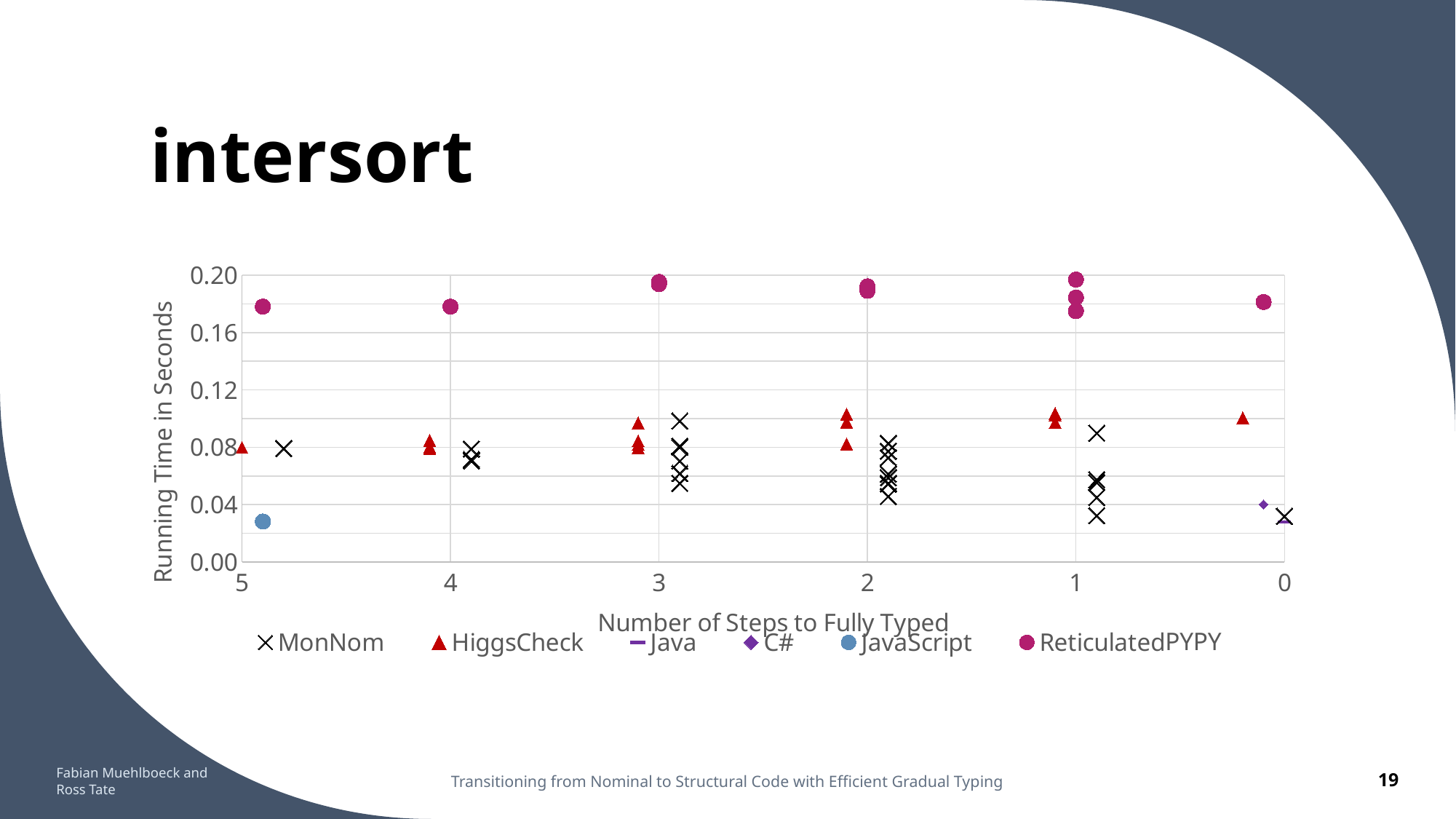
Is the ReticulatedPYPY value at 5 steps greater or less than 0.16? greater How many series does the legend list? 6 At 5 steps, which series has the higher running time, ReticulatedPYPY or HiggsCheck? ReticulatedPYPY What is the label of the vertical axis? Running Time in Seconds Is the JavaScript value at 5 steps greater or less than 0.04? less What kind of chart is shown on the slide? scatter chart At 0 steps, which series has the higher running time, HiggsCheck or C#? HiggsCheck Which series has the highest running times across the chart? ReticulatedPYPY At 5 steps, which series has the lowest running time? JavaScript Is the HiggsCheck value at 0 steps greater or less than 0.08? greater What is the title of the slide/chart? intersort